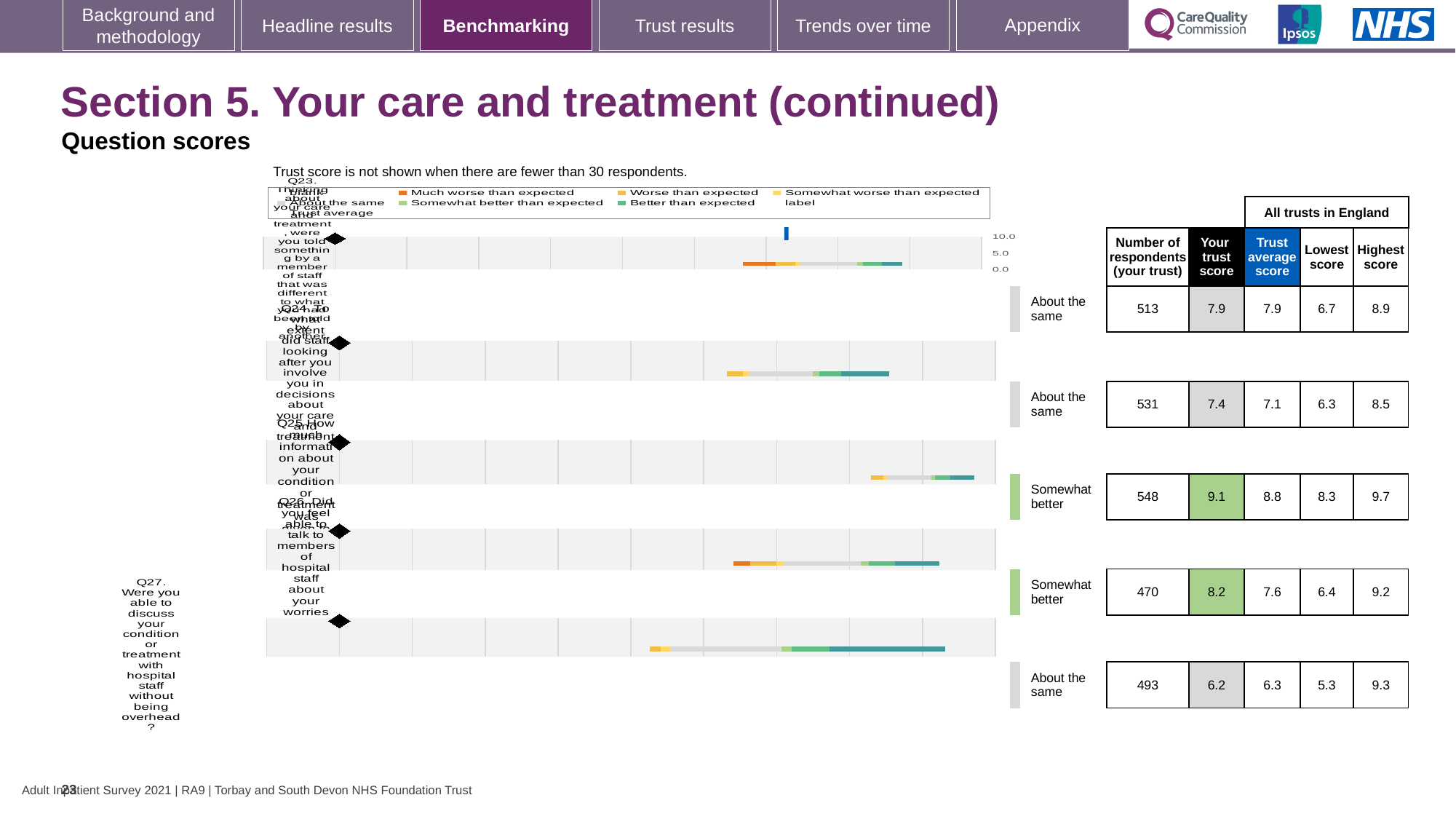
Which question has the lowest 'Your trust score'? Q27 For Q24, which is larger: 'Your trust score' or the 'Trust average score'? Your trust score What is the 'Your trust score' for Q25 (how much information about your condition or treatment was given to you)? 9.1 What kind of chart is shown on the slide? bar chart What is the 'Lowest score' across all trusts in England for Q23? 6.7 What benchmark category is shown for Q25? Somewhat better How many questions (categories) are plotted in the chart? 5 What is the 'Highest score' across all trusts in England for Q27 (discuss your condition or treatment without being overheard)? 9.3 According to the note above the chart, when is the trust score not shown? When there are fewer than 30 respondents Which question has the highest 'Your trust score'? Q25 How many respondents (your trust) are shown for Q24 (did staff involve you in decisions about your care and treatment)? 531 For Q26 (able to talk to hospital staff about your worries), what is the difference between 'Your trust score' and the 'Trust average score'? 0.6